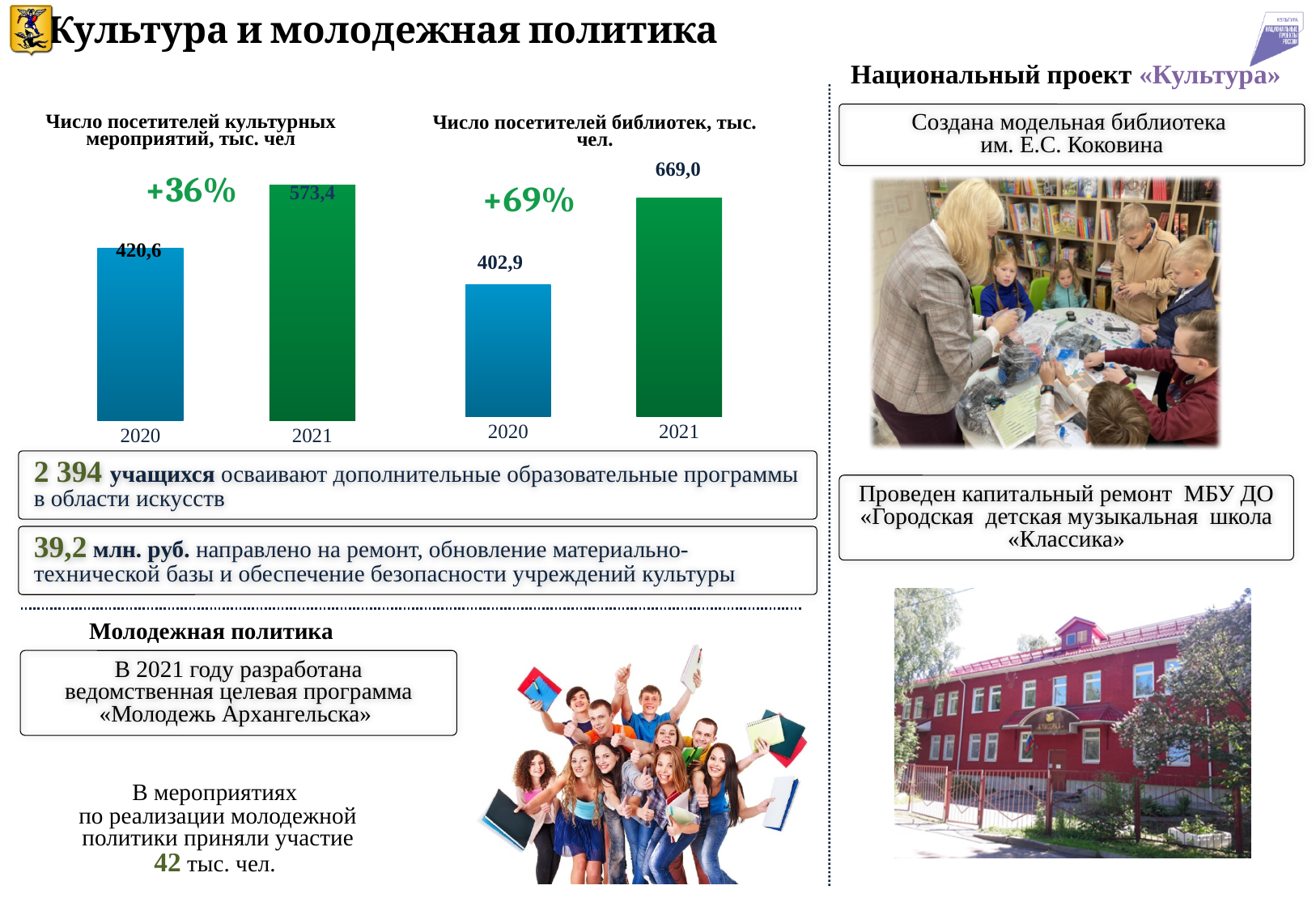
In the chart 'Число посетителей культурных мероприятий, тыс. чел', which year has the higher value? 2021 In the chart 'Число посетителей библиотек, тыс. чел.', do the values rise or fall from 2020 to 2021? Rise What type of chart is 'Число посетителей культурных мероприятий, тыс. чел'? Bar chart In the chart 'Число посетителей библиотек, тыс. чел.', what is the value for 2020? 402,9 In the chart 'Число посетителей библиотек, тыс. чел.', what is the value for 2021? 669,0 In the chart 'Число посетителей библиотек, тыс. чел.', what is the difference between the 2021 and 2020 values? 266,1 In the chart 'Число посетителей культурных мероприятий, тыс. чел', what is the value for 2020? 420,6 In the chart 'Число посетителей библиотек, тыс. чел.', how many bars are plotted? 2 In the chart 'Число посетителей культурных мероприятий, тыс. чел', what is the difference between the 2021 and 2020 values? 152,8 In the chart 'Число посетителей культурных мероприятий, тыс. чел', what is the value for 2021? 573,4 In the chart 'Число посетителей библиотек, тыс. чел.', which year has the lower value? 2020 What percentage change is printed on the chart 'Число посетителей библиотек, тыс. чел.'? +69%